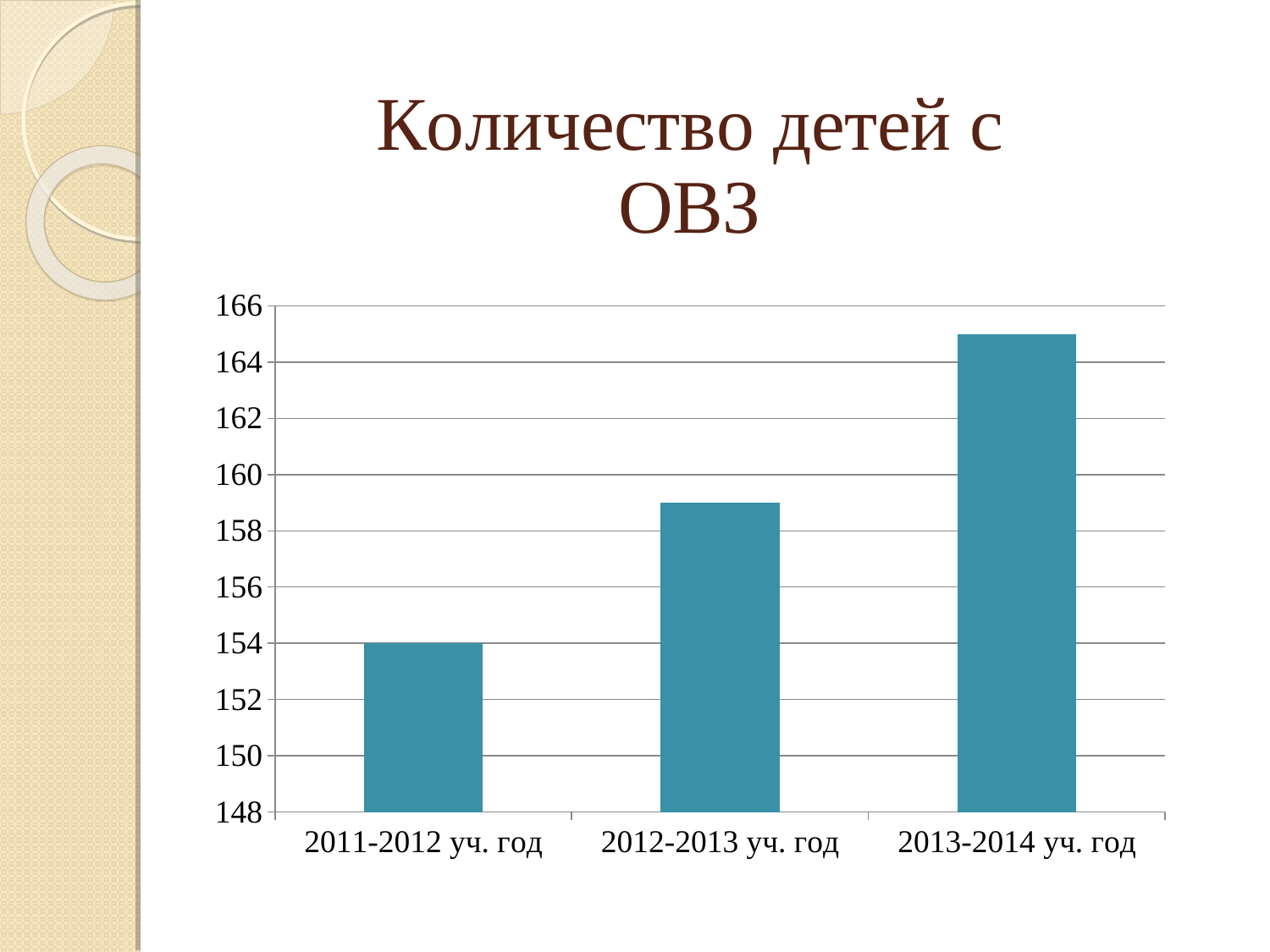
Which academic year has the lowest value? 2011-2012 уч. год What kind of chart is shown on the slide? bar chart What is the title of the chart? Количество детей с ОВЗ Is the value for 2012-2013 уч. год greater or less than 160? less Which is larger, the value for 2012-2013 уч. год or the value for 2013-2014 уч. год? 2013-2014 уч. год What is the value for 2011-2012 уч. год? 154 Which academic year has the highest value? 2013-2014 уч. год Is the value for 2013-2014 уч. год greater or less than 164? greater Is the value for 2012-2013 уч. год greater or less than 158? greater What is the lowest value shown on the vertical axis? 148 How many categories (academic years) are shown on the x axis? 3 Do the values rise or fall from 2011-2012 уч. год to 2013-2014 уч. год? rise